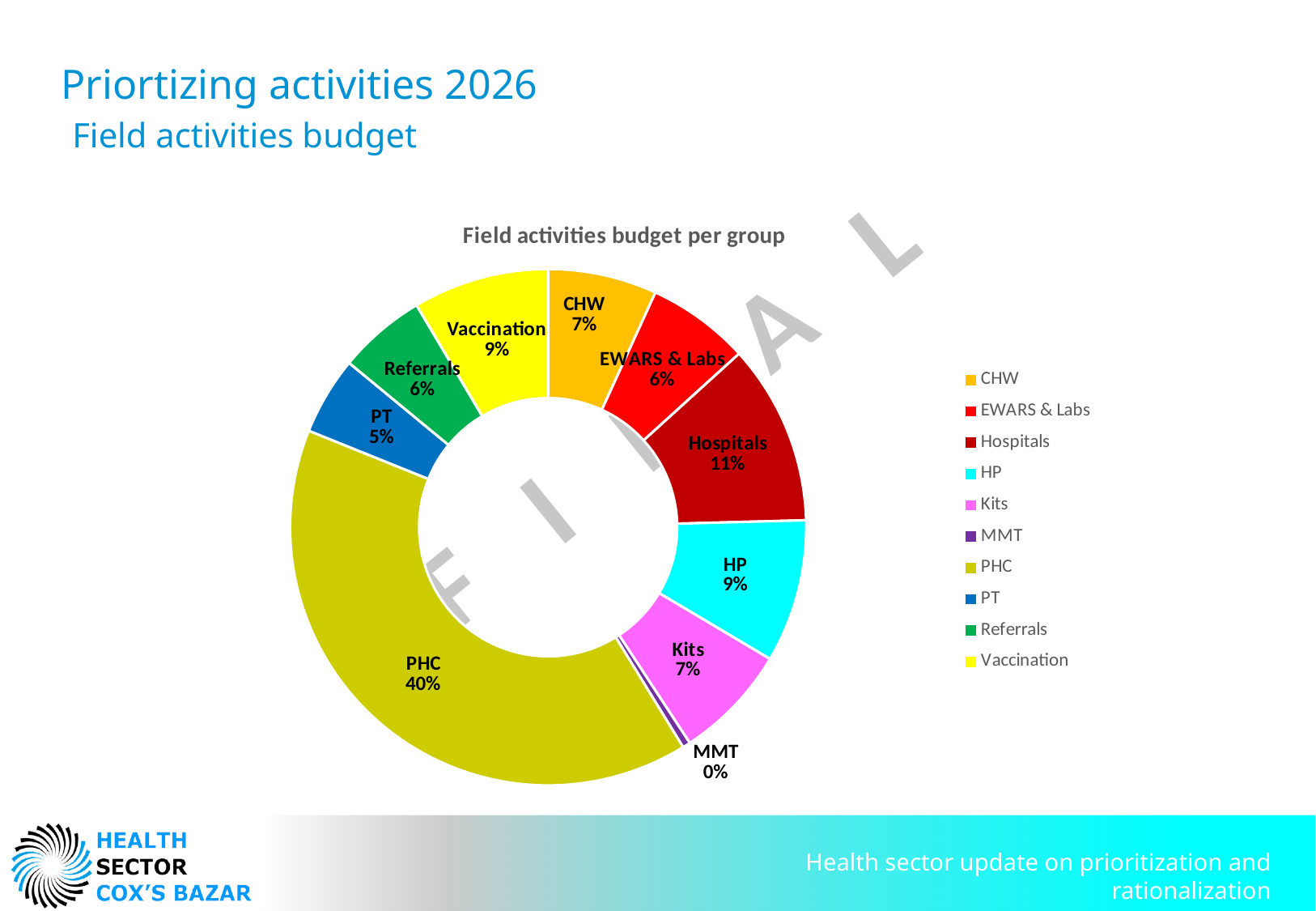
What is the title of the chart? Field activities budget per group How many groups are shown in the chart? 10 What percentage is shown for PT? 5% Which group has the smallest share of the field activities budget? MMT What percentage is shown for Vaccination? 9% What is the difference in percentage points between PHC and Hospitals? 29 What share of the field activities budget goes to PHC? 40% Which has a larger share, Hospitals or HP? Hospitals What colour is the PHC segment in the chart? Olive/yellow-green What percentage is shown for Hospitals? 11% Which group has the largest share of the field activities budget? PHC What kind of chart is shown on the slide? Doughnut (pie) chart